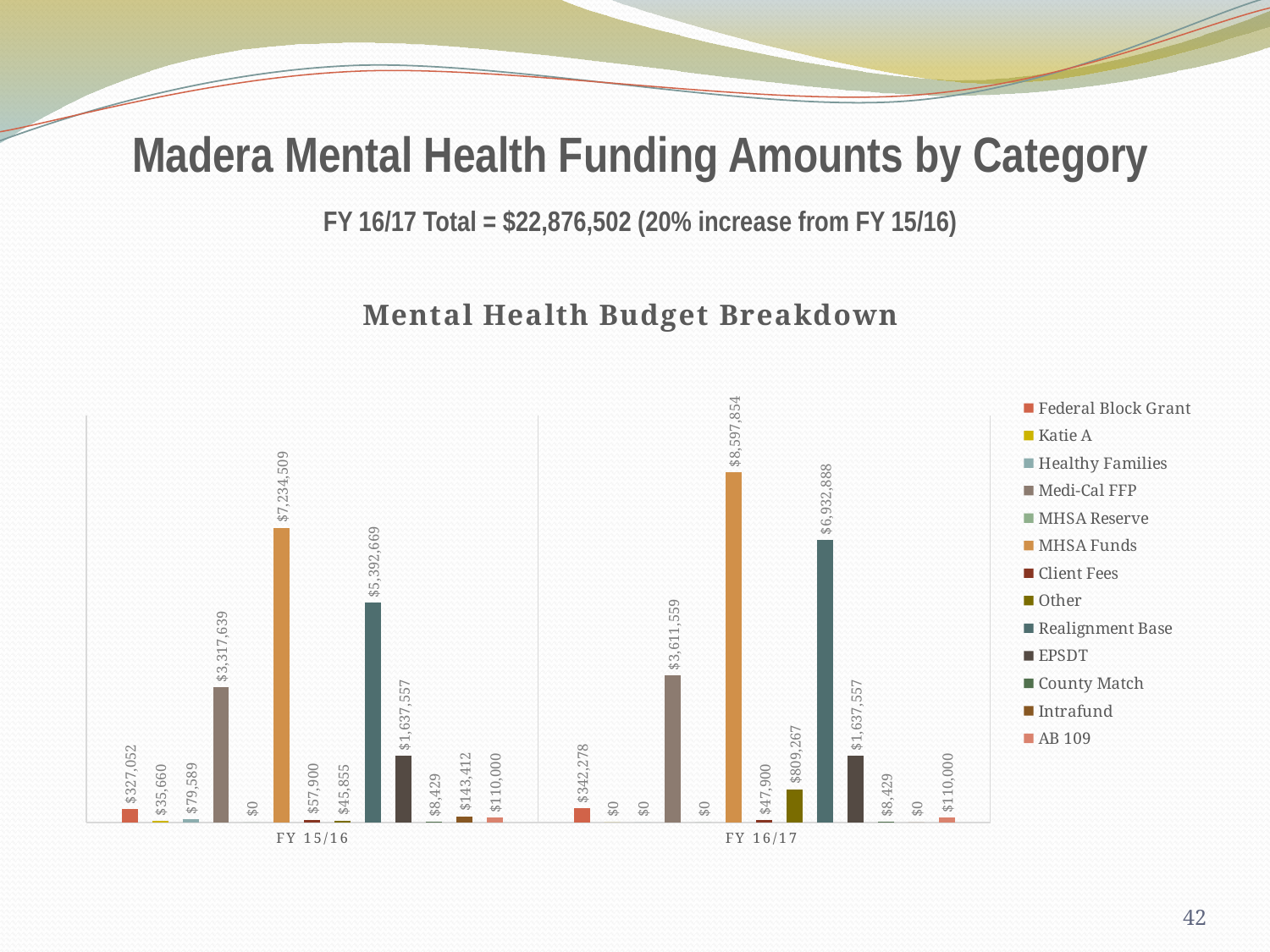
What is the title of the chart? Mental Health Budget Breakdown What is the difference between the MHSA Funds values for FY 16/17 and FY 15/16? $1,363,345 Which funding category has the highest value in FY 15/16? MHSA Funds What is the value of Realignment Base for FY 15/16? $5,392,669 What is the value of Other for FY 16/17? $809,267 What is the difference between the Realignment Base values for FY 16/17 and FY 15/16? $1,540,219 Which funding category has the highest value in FY 16/17? MHSA Funds What is the value of MHSA Funds for FY 16/17? $8,597,854 What type of chart is shown on the slide? bar chart What is the value of Medi-Cal FFP for FY 16/17? $3,611,559 How many series does the legend list? 13 Which is larger: Medi-Cal FFP in FY 15/16 or Realignment Base in FY 15/16? Realignment Base in FY 15/16